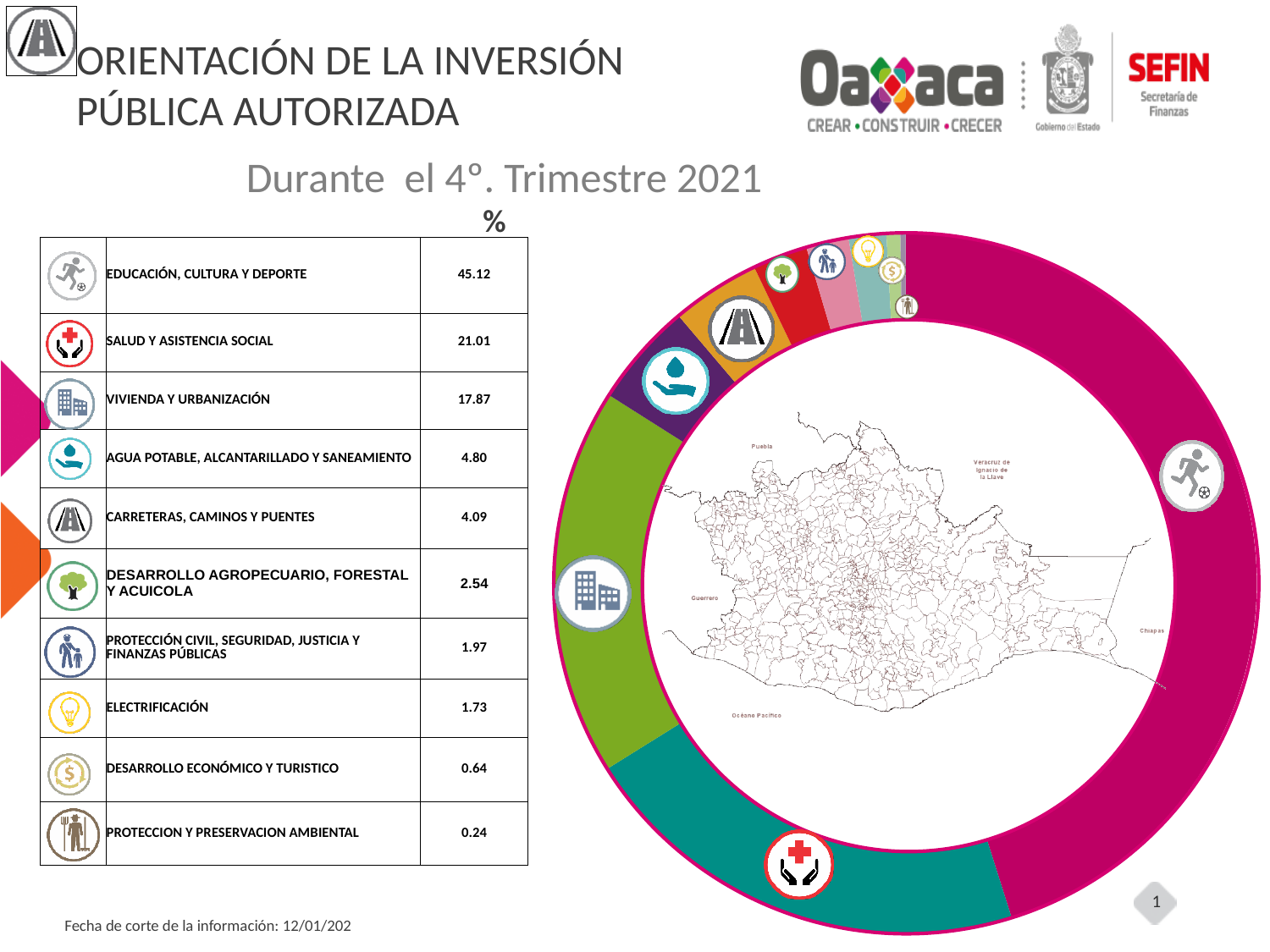
What is the difference in percentage points between DESARROLLO AGROPECUARIO, FORESTAL Y ACUICOLA and DESARROLLO ECONÓMICO Y TURISTICO? 1.90 Which category has the smallest share of the authorized public investment? PROTECCION Y PRESERVACION AMBIENTAL Which is larger, the share for AGUA POTABLE, ALCANTARILLADO Y SANEAMIENTO or for CARRETERAS, CAMINOS Y PUENTES? AGUA POTABLE, ALCANTARILLADO Y SANEAMIENTO What percentage is shown for VIVIENDA Y URBANIZACIÓN? 17.87 How many categories are listed in the table of authorized public investment? 10 What kind of chart is shown on the right of the slide? doughnut chart Which period does the chart cover, according to the subtitle? Durante el 4º. Trimestre 2021 What percentage is shown for ELECTRIFICACIÓN? 1.73 What percentage is shown for SALUD Y ASISTENCIA SOCIAL? 21.01 What percentage is shown for EDUCACIÓN, CULTURA Y DEPORTE? 45.12 Which category has the largest share of the authorized public investment? EDUCACIÓN, CULTURA Y DEPORTE What is the difference in percentage points between SALUD Y ASISTENCIA SOCIAL and VIVIENDA Y URBANIZACIÓN? 3.14